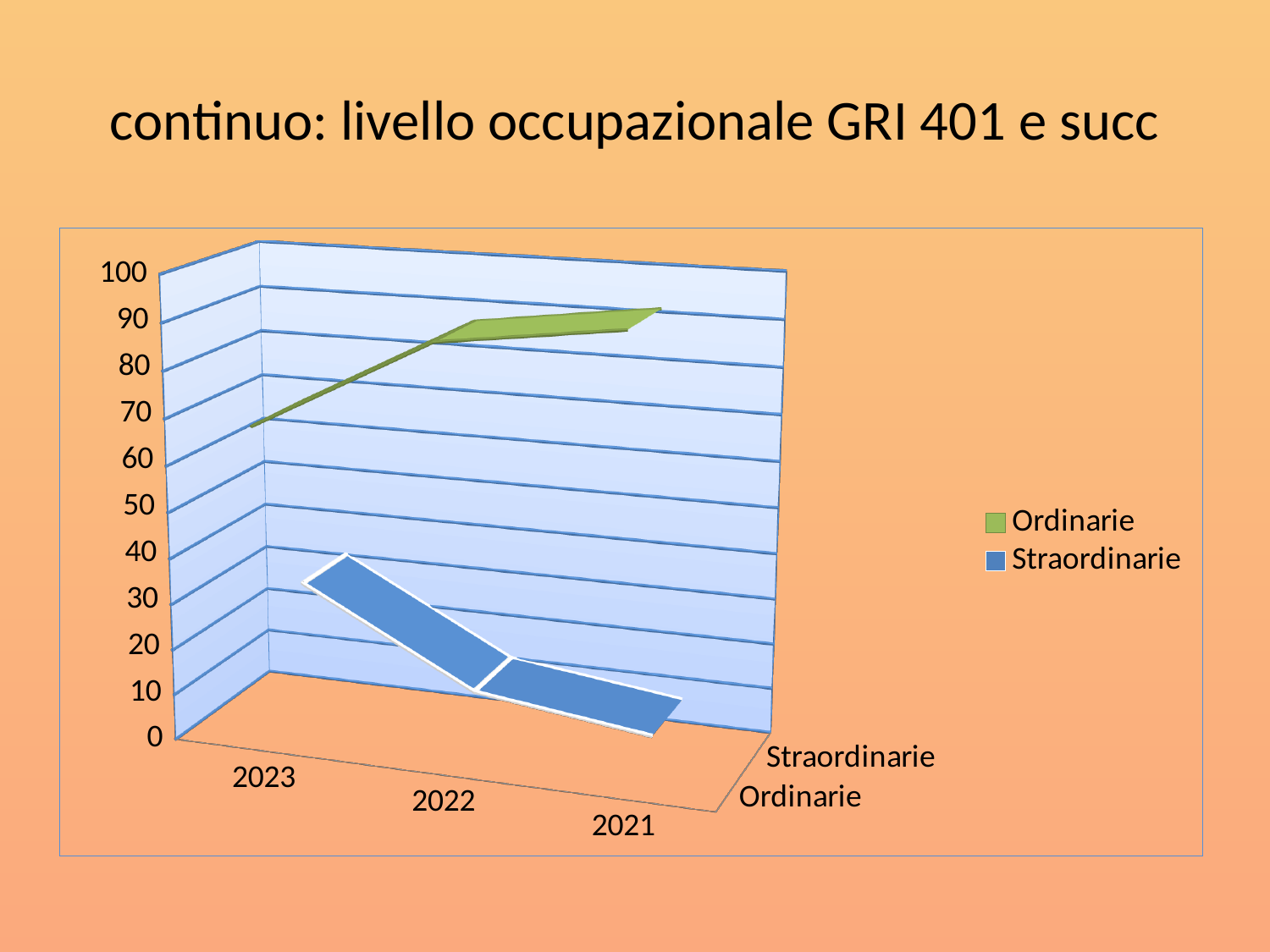
Is the value for Ordinarie in 2022 greater or less than 70? greater What kind of chart is shown on the slide? line chart In which year is the Ordinarie series lowest? 2023 Is the value for Straordinarie in 2021 greater or less than 30? less What is the title of the slide containing the chart? continuo: livello occupazionale GRI 401 e succ Is the value for Ordinarie in 2023 greater or less than 50? greater In which year is the Straordinarie series highest? 2023 In 2023, which series has the larger value, Ordinarie or Straordinarie? Ordinarie Which series are listed in the legend? Ordinarie and Straordinarie How many series does the legend list? 2 How many years are shown along the x axis? 3